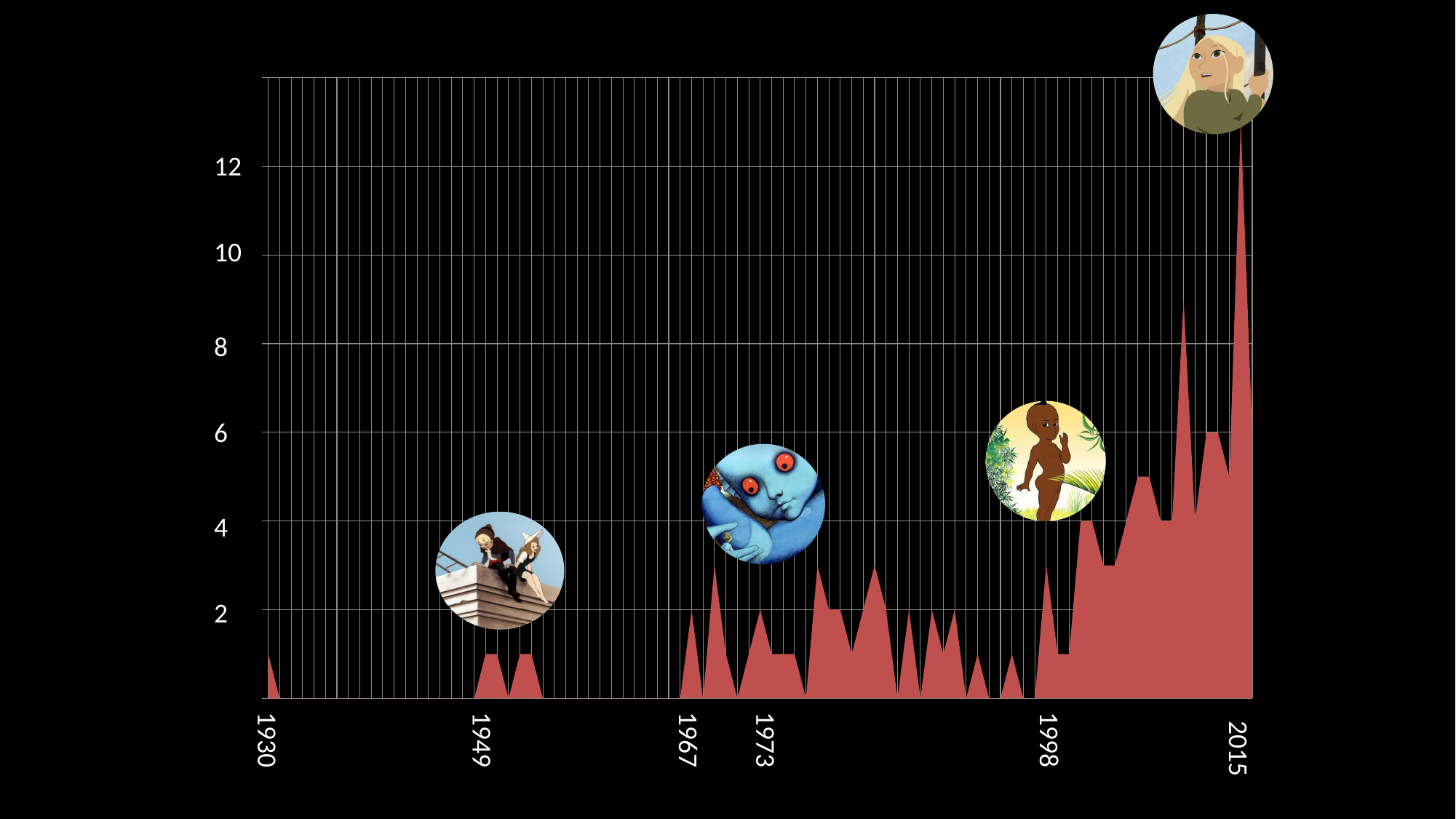
What kind of chart is shown on the slide? area chart Is the value for 1973 greater or less than 4? less Which has the larger value, 1998 or 1930? 1998 Do the values generally rise or fall from 1930 to 2015? rise Which has the larger value, 2015 or 1998? 2015 Is the value for 2015 greater or less than 10? greater How many year labels are shown on the x axis? 6 What is the highest tick value shown on the y axis? 12 Is the value for 1930 greater or less than 2? less Which labeled year on the x axis has the highest value? 2015